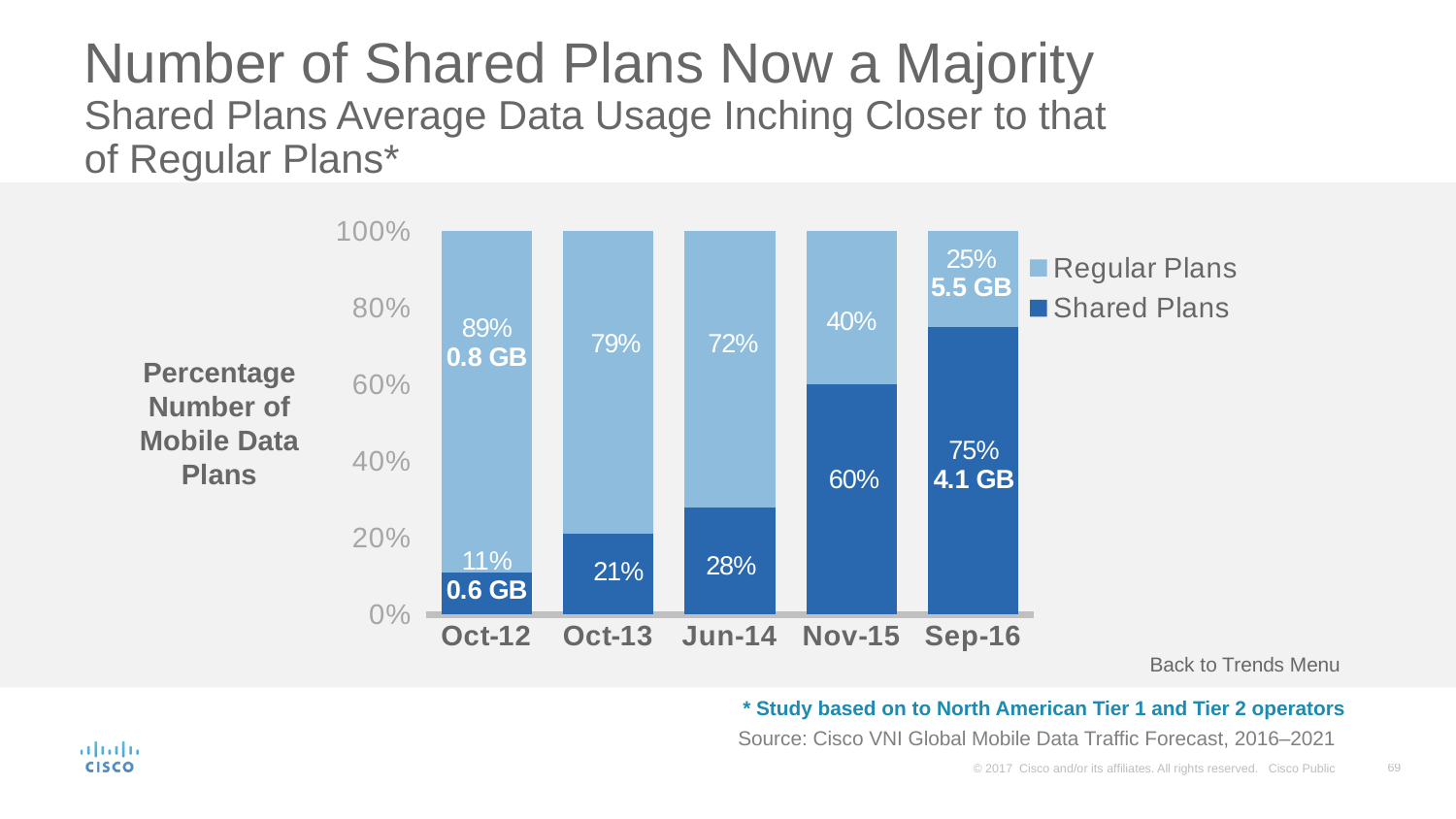
In which period was the Regular Plans percentage lowest? Sep-16 What kind of chart is shown on the slide? Stacked bar chart What average data usage is shown for Shared Plans in Sep-16? 4.1 GB What percentage of mobile data plans were Shared Plans in Oct-12? 11% How many series does the legend list? 2 Which is larger in Jun-14: the Regular Plans share or the Shared Plans share? Regular Plans What percentage of mobile data plans were Regular Plans in Sep-16? 25% Does the Shared Plans percentage rise or fall from Oct-12 to Sep-16? Rise What was the Shared Plans percentage in Nov-15? 60% How many time periods are shown on the x axis? 5 In which period was the Shared Plans percentage highest? Sep-16 What is the difference between the Shared Plans percentage in Sep-16 and in Oct-12? 64 percentage points